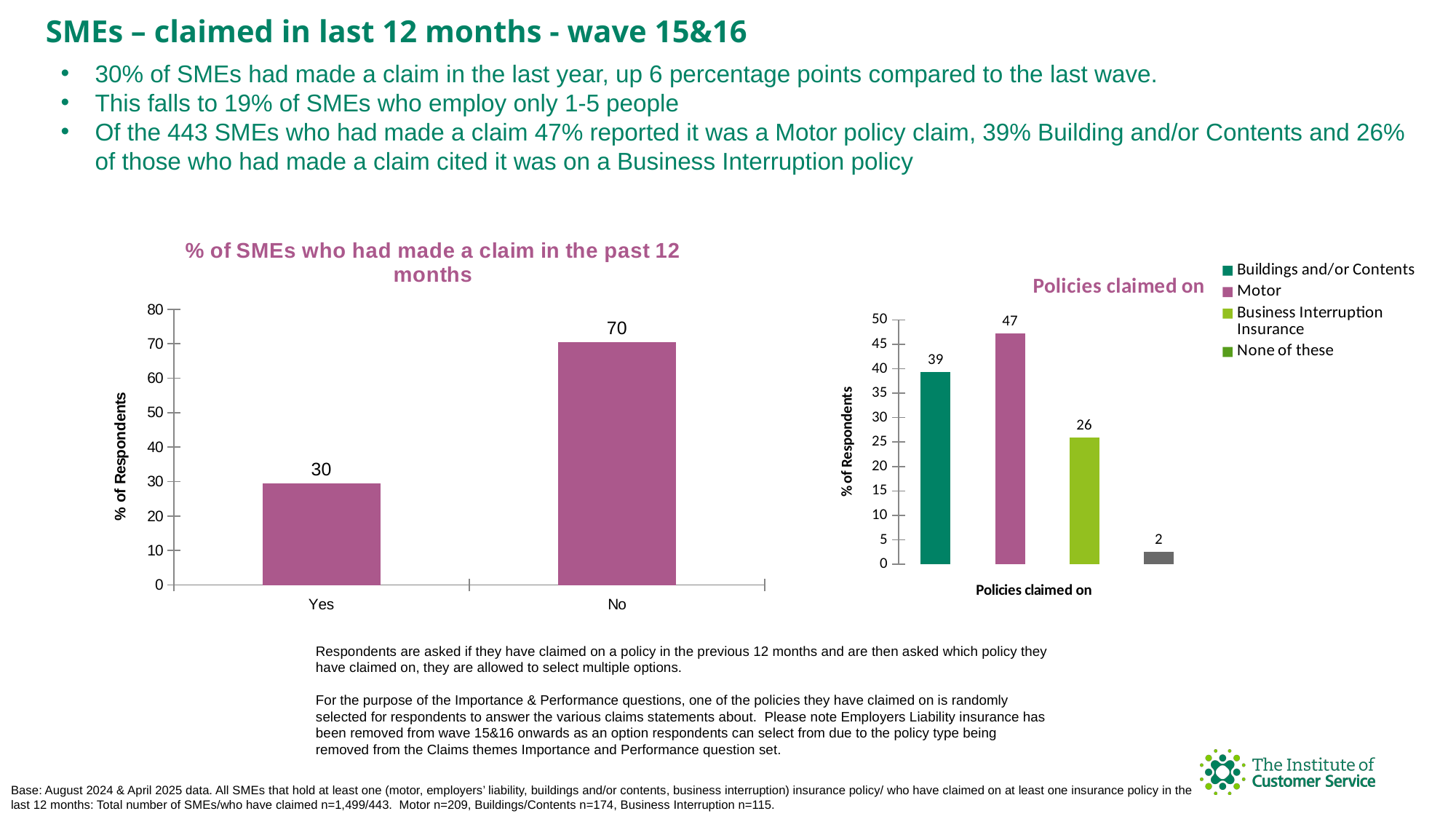
In the 'Policies claimed on' chart, which category has the lowest value? None of these In the chart '% of SMEs who had made a claim in the past 12 months', what is the value for 'No'? 70 In the chart '% of SMEs who had made a claim in the past 12 months', how many categories are shown on the x axis? 2 What kind of chart is '% of SMEs who had made a claim in the past 12 months'? Bar chart In the 'Policies claimed on' chart, which policy has the highest value? Motor In the 'Policies claimed on' chart, what is the difference between Motor and Buildings and/or Contents? 8 In the 'Policies claimed on' chart, which is larger: Buildings and/or Contents or Business Interruption Insurance? Buildings and/or Contents In the 'Policies claimed on' chart, how many entries does the legend list? 4 In the chart '% of SMEs who had made a claim in the past 12 months', what is the value for 'Yes'? 30 In the chart '% of SMEs who had made a claim in the past 12 months', what is the difference between the 'No' and 'Yes' values? 40 In the 'Policies claimed on' chart, what is the value for Motor? 47 In the 'Policies claimed on' chart, what is the value for Business Interruption Insurance? 26